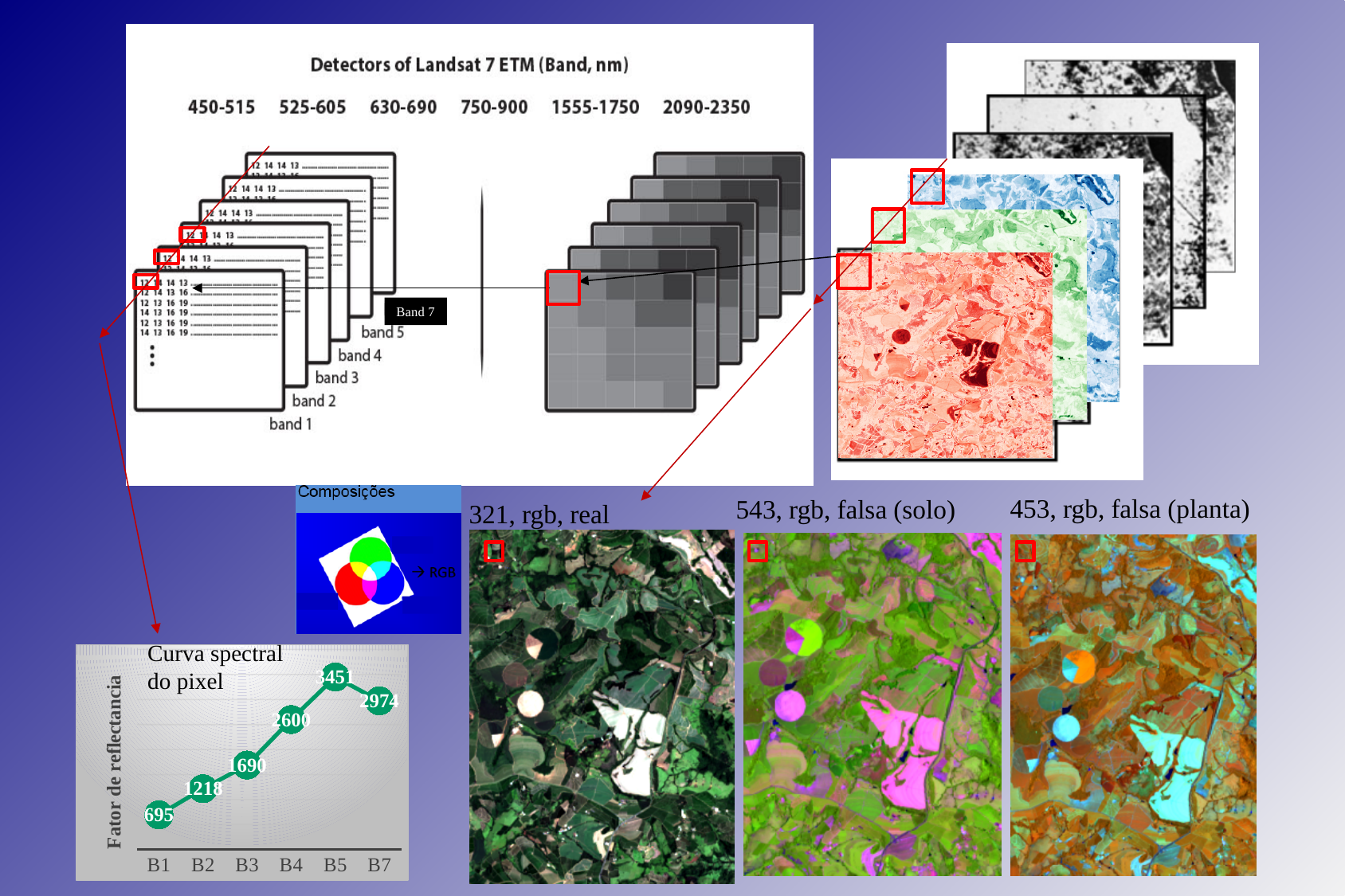
Which band has the highest value in the 'Curva spectral do pixel' chart? B5 What is the value for B7 in the 'Curva spectral do pixel' chart? 2974 In the 'Curva spectral do pixel' chart, do the values rise or fall from B1 to B5? rise What is the value for B4 in the 'Curva spectral do pixel' chart? 2600 What is the y-axis label of the 'Curva spectral do pixel' chart? Fator de reflectancia In the 'Curva spectral do pixel' chart, which is larger, the value for B3 or the value for B4? B4 In the 'Curva spectral do pixel' chart, what is the difference between the values for B5 and B7? 477 In the 'Curva spectral do pixel' chart, what is the difference between the values for B2 and B1? 523 What is the value for B1 in the 'Curva spectral do pixel' chart? 695 How many bands are plotted on the x axis of the 'Curva spectral do pixel' chart? 6 What kind of chart is the 'Curva spectral do pixel' chart? line chart Which band has the lowest value in the 'Curva spectral do pixel' chart? B1